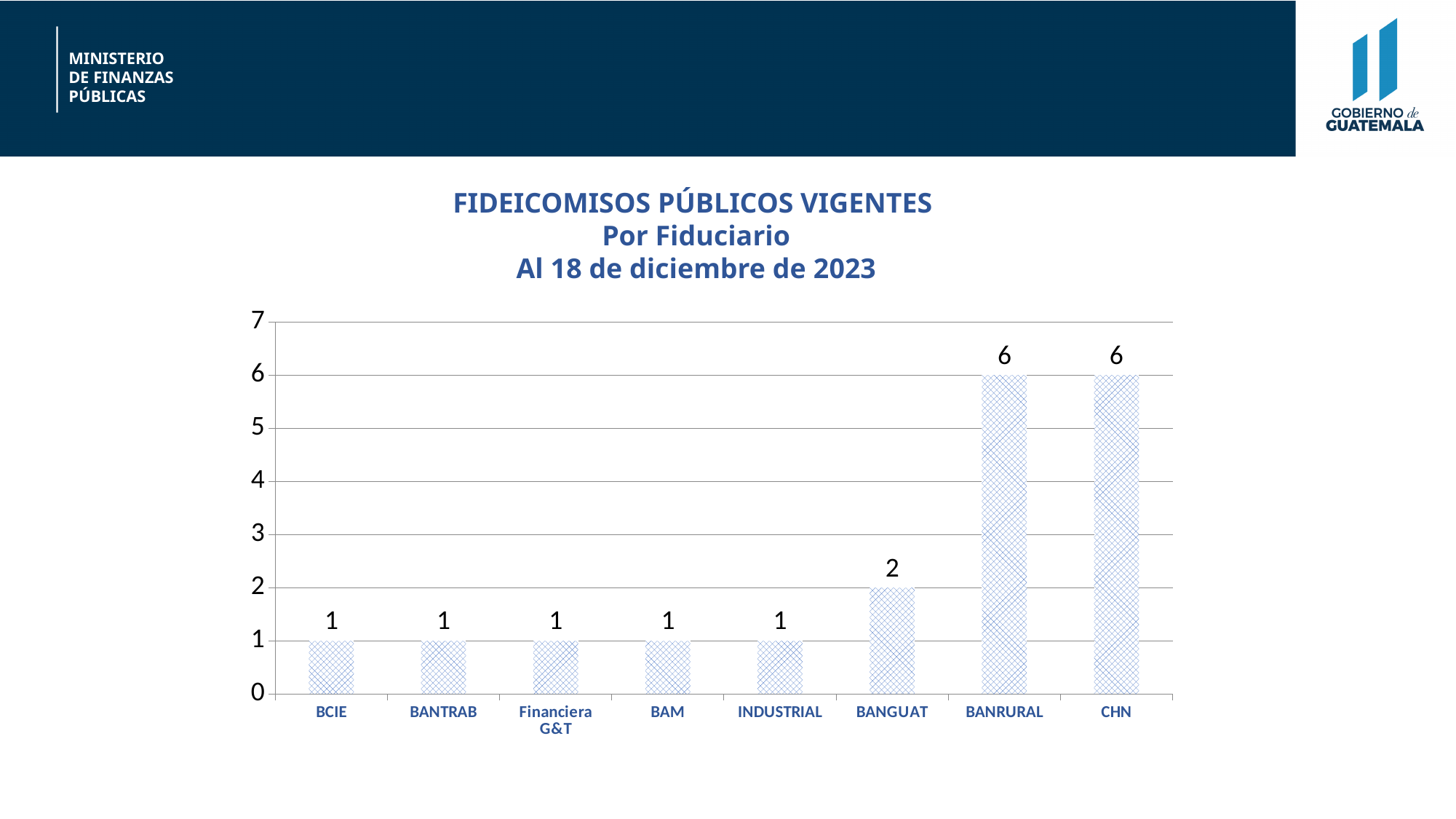
Is the value for BANRURAL greater or less than 4? greater Which is larger, the value for BANGUAT or the value for BAM? BANGUAT What is the value for BANGUAT? 2 What is the value for BANRURAL? 6 What is the value for BCIE? 1 Which category has the lowest value among BANGUAT, BANRURAL and CHN? BANGUAT What is the value for Financiera G&T? 1 What is the difference between the values for CHN and BANGUAT? 4 How many categories are shown on the x axis? 8 What is the date given in the chart title? 18 de diciembre de 2023 What kind of chart is shown on the slide? bar chart What is the difference between the values for BANGUAT and INDUSTRIAL? 1